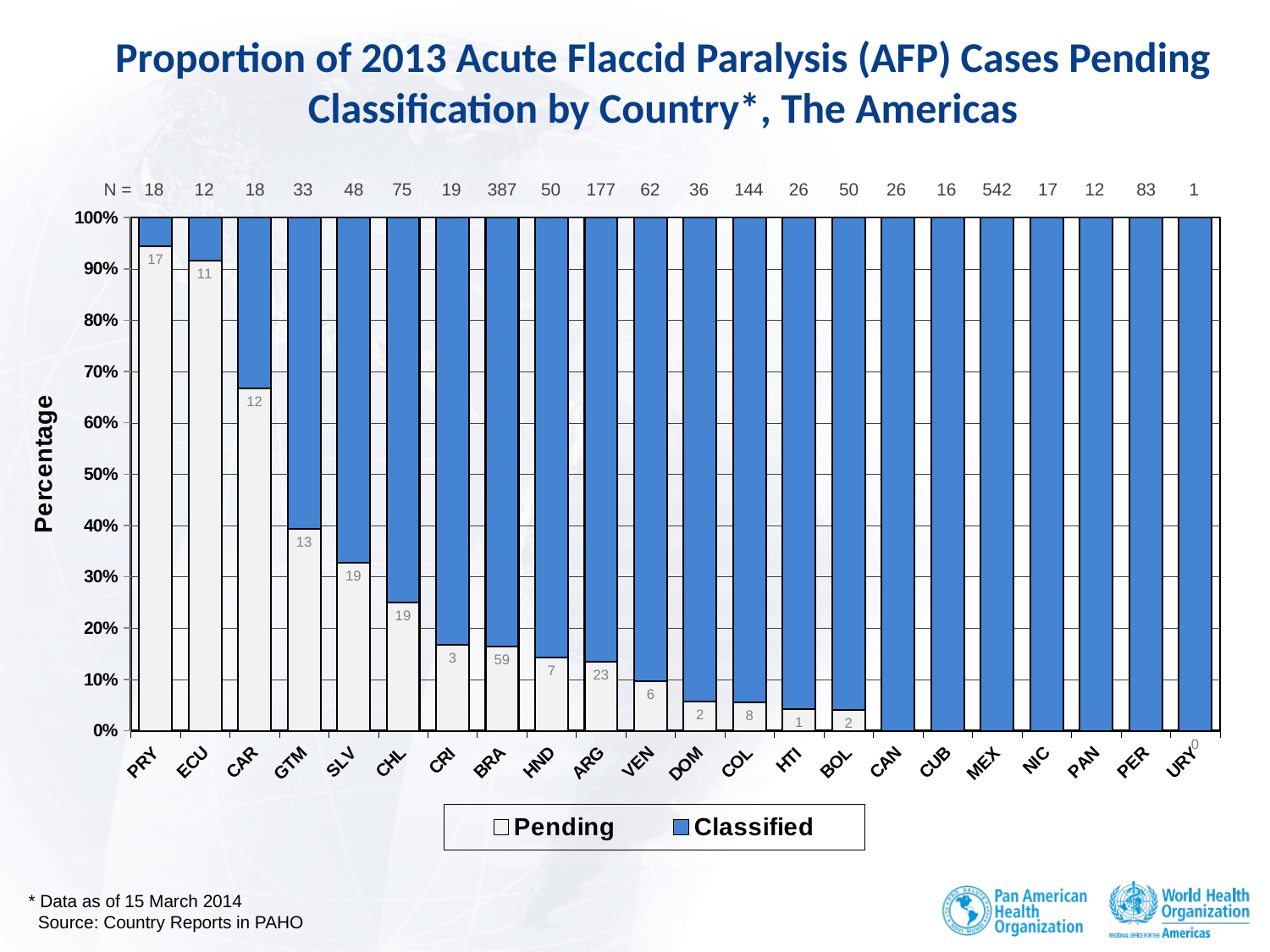
What is the difference between the pending case counts labelled for BRA and ARG? 36 What kind of chart is shown on the slide? stacked bar chart How many series does the legend list? 2 How many countries are shown along the x axis? 22 Which country has the highest proportion of pending cases? PRY What is the N value shown above the bar for MEX? 542 Is the pending proportion for GTM greater or less than 50%? less Which has a larger pending proportion, CAR or SLV? CAR Is the pending proportion for PRY greater or less than 90%? greater What is the number of pending cases labelled on the bar for ARG? 23 What is the number of pending cases labelled on the bar for BRA? 59 What are the two legend entries? Pending and Classified